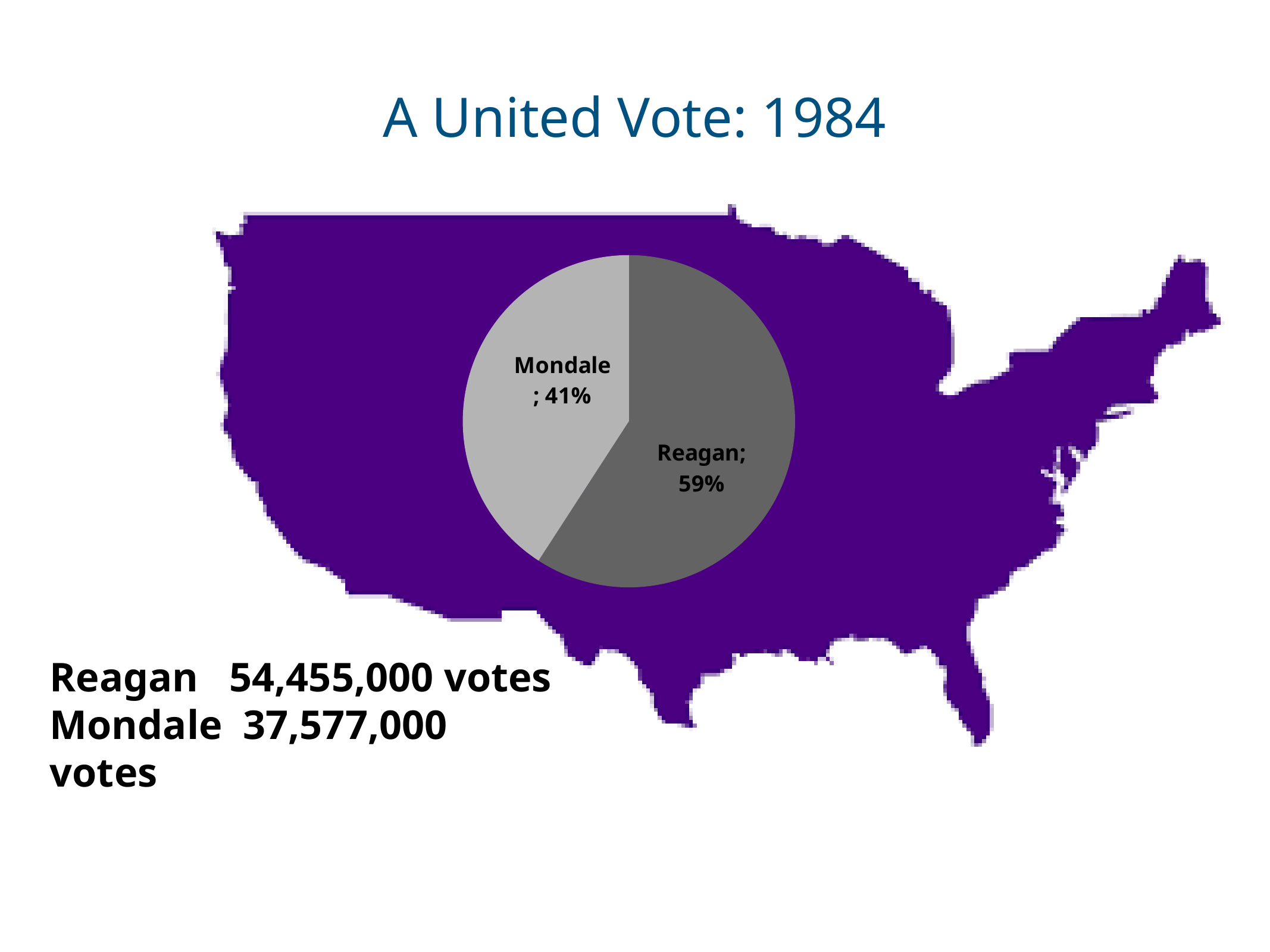
Which candidate has the largest slice of the pie? Reagan What is the title of the slide containing the pie chart? A United Vote: 1984 What is the difference in percentage points between Reagan's and Mondale's slices? 18 percentage points What share of the pie does Reagan's slice represent? 59% What kind of chart is shown on the slide? pie chart Which slice of the pie is shaded in the darker grey? Reagan How many slices does the pie chart have? 2 Which slice is larger, Reagan's or Mondale's? Reagan's Which candidate has the smallest slice of the pie? Mondale What share of the pie does Mondale's slice represent? 41%